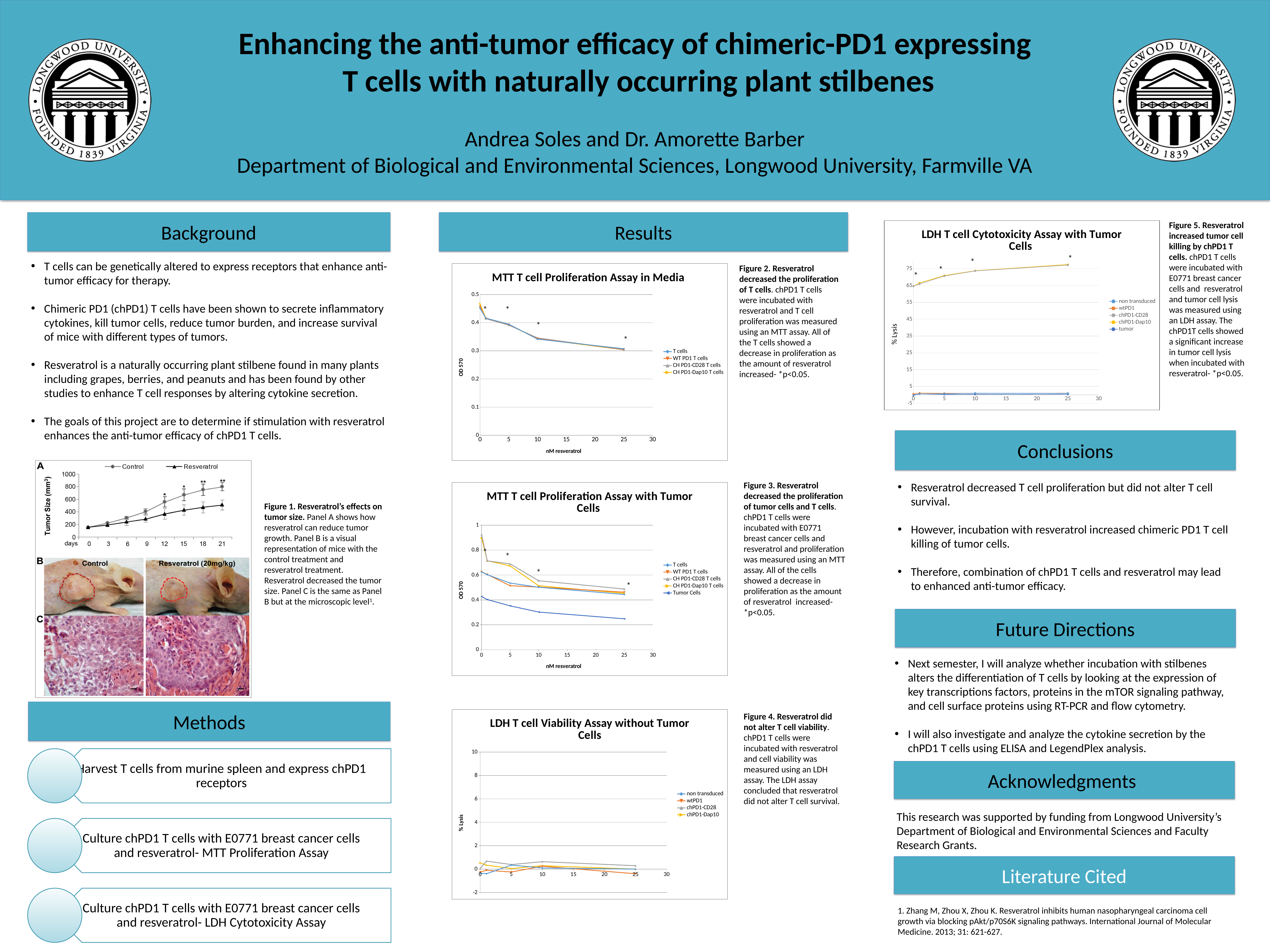
What is the x-axis label of the "MTT T cell Proliferation Assay in Media" chart? nM resveratrol In the "MTT T cell Proliferation Assay in Media" chart, is the OD 570 value for T cells at 25 nM resveratrol greater or less than 0.4? less In the "MTT T cell Proliferation Assay with Tumor Cells" chart, at 0 nM resveratrol, which is larger: the value for WT PD1 T cells or the value for Tumor Cells? WT PD1 T cells How many series does the legend of the "MTT T cell Proliferation Assay in Media" chart list? 4 In the "MTT T cell Proliferation Assay in Media" chart, do the OD 570 values rise or fall as nM resveratrol increases? fall How many series does the legend of the "LDH T cell Viability Assay without Tumor Cells" chart list? 4 In the "LDH T cell Cytotoxicity Assay with Tumor Cells" chart, is the % Lysis value for chPD1-Dap10 at 25 greater or less than 65? greater What kind of chart is the "MTT T cell Proliferation Assay in Media" chart? line chart In the "MTT T cell Proliferation Assay with Tumor Cells" chart, is the OD 570 value for Tumor Cells at 25 nM resveratrol greater or less than 0.4? less How many series does the legend of the "MTT T cell Proliferation Assay with Tumor Cells" chart list? 5 In the "MTT T cell Proliferation Assay with Tumor Cells" chart, which series has the lowest OD 570 values across the x axis? Tumor Cells